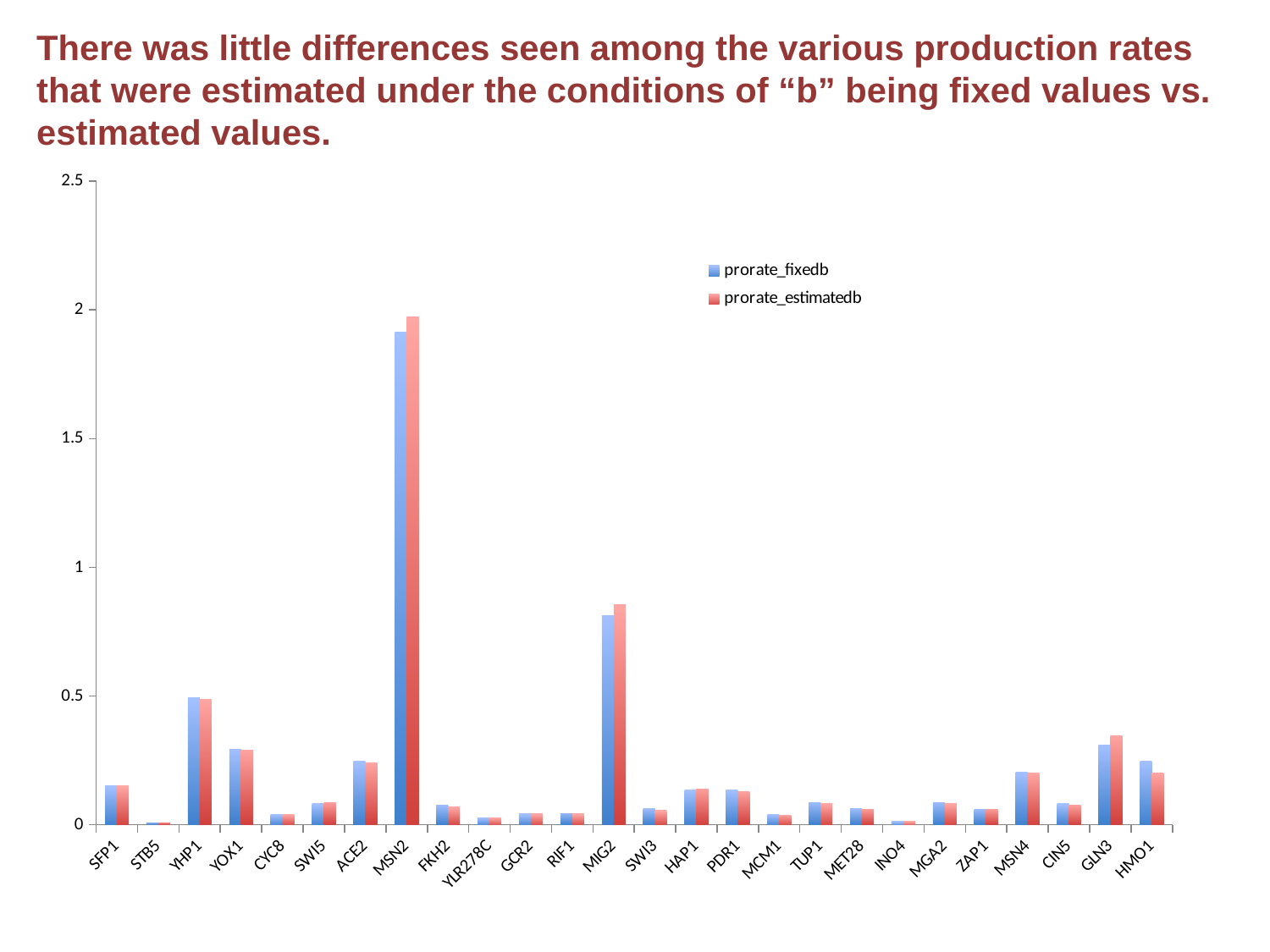
Which category has the highest value for prorate_estimatedb? MSN2 Is the prorate_fixedb value for MIG2 greater or less than 0.5? greater Which is larger for prorate_fixedb: MSN2 or MIG2? MSN2 Which is larger for prorate_estimatedb: YHP1 or YOX1? YHP1 Is the prorate_fixedb value for YHP1 greater or less than 1? less Is the prorate_estimatedb value for GLN3 greater or less than 0.5? less How many categories are shown along the x axis? 26 What are the two series names listed in the legend? prorate_fixedb and prorate_estimatedb How many series does the legend list? 2 Which category has the highest value for prorate_fixedb? MSN2 What kind of chart is shown on the slide? bar chart